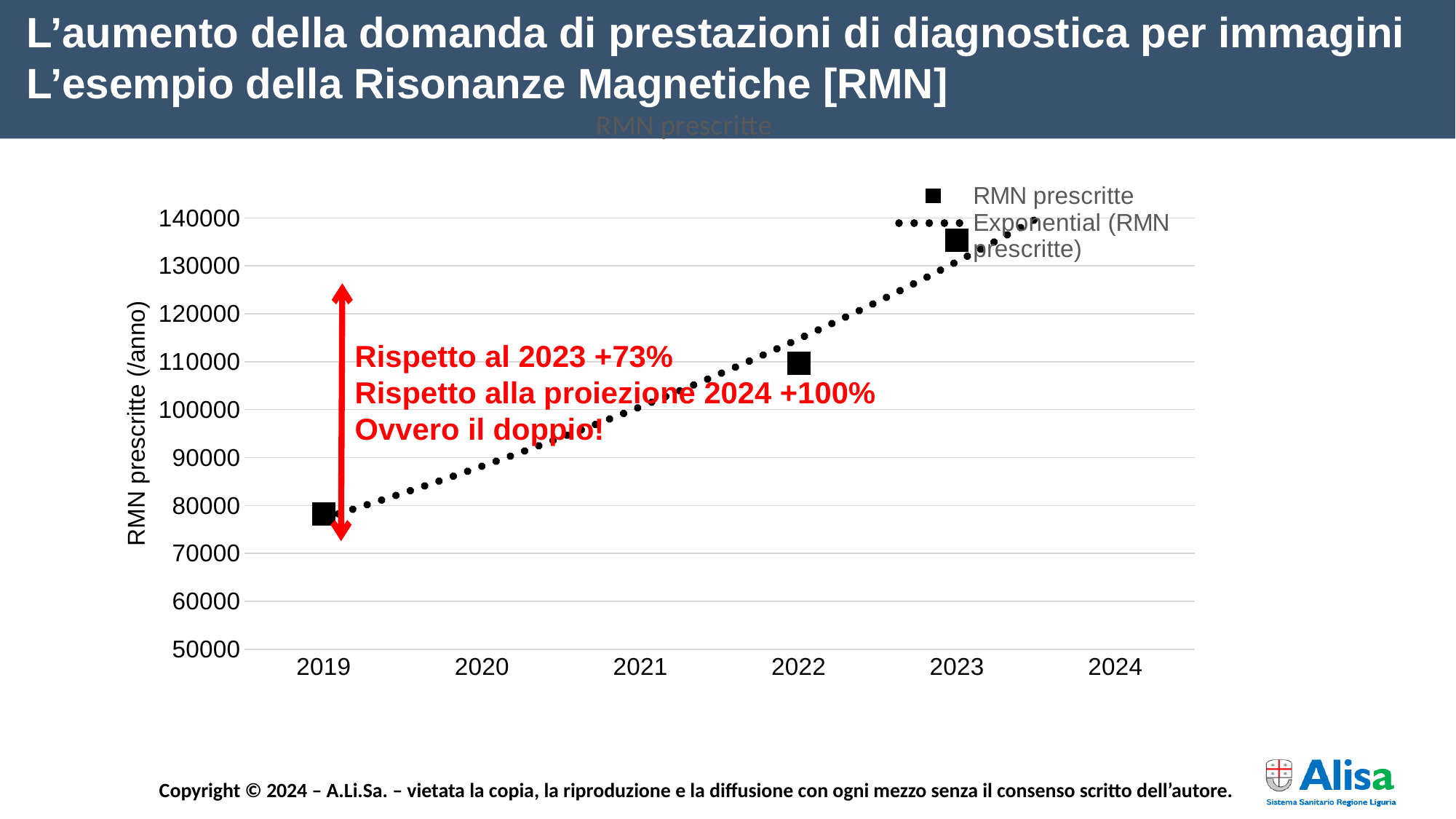
Which year has the larger value for RMN prescritte, 2019 or 2022? 2022 Is the value for RMN prescritte in 2022 greater or less than 100000? greater What is the title of the vertical axis of the chart? RMN prescritte (/anno) What kind of chart is shown on the slide? scatter chart Which year has the highest value for RMN prescritte? 2023 Is the value for RMN prescritte in 2023 greater or less than 140000? less How many entries does the chart legend list? 2 How many data points are plotted for the RMN prescritte series? 3 Is the value for RMN prescritte in 2023 greater or less than 130000? greater Which year has the lowest value for RMN prescritte? 2019 Do the RMN prescritte values rise or fall from 2019 to 2023? rise